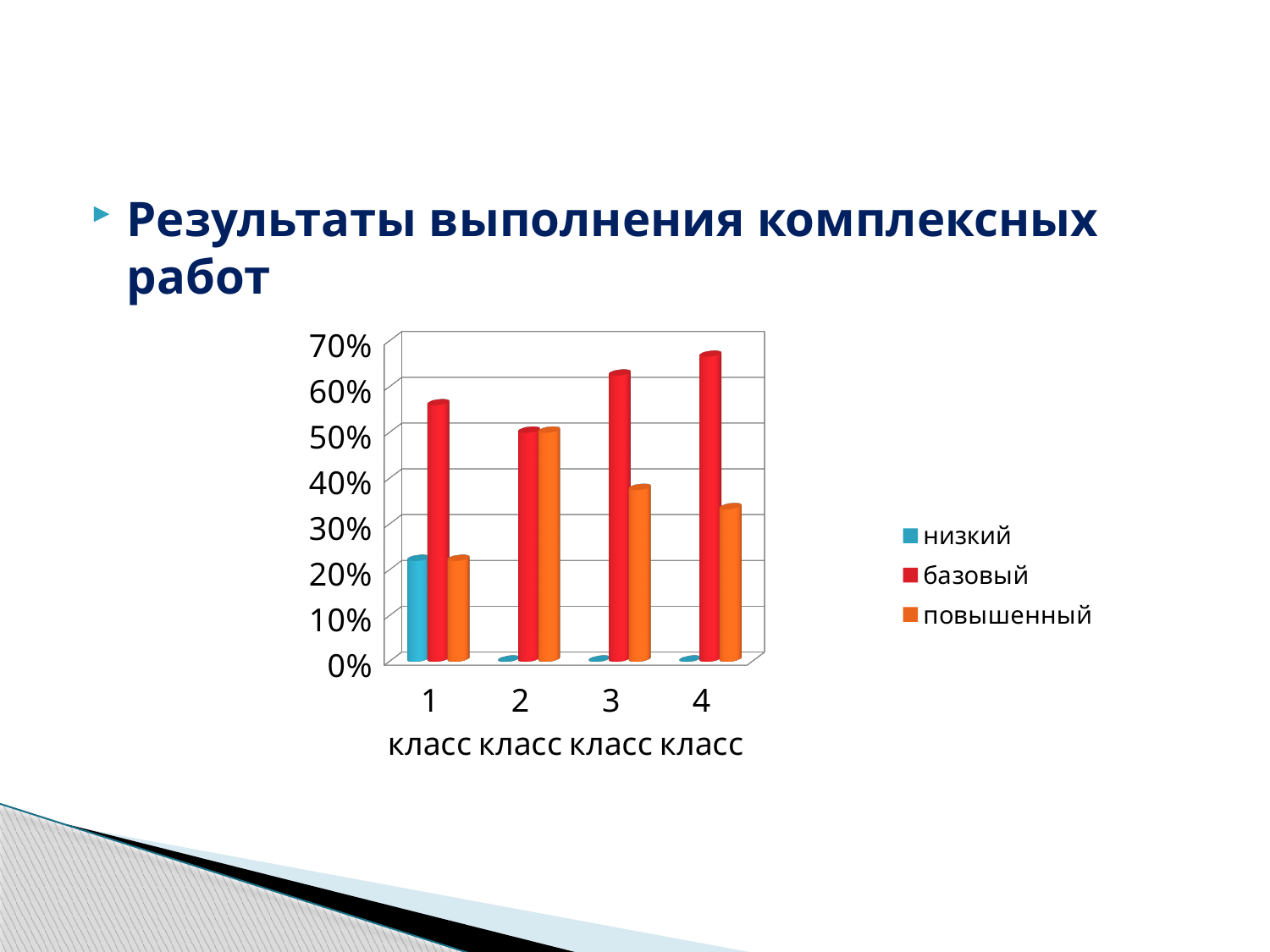
Is the value of повышенный for 4 класс greater or less than 40%? less What kind of chart is shown on the slide? bar chart Which class has the lowest value for повышенный? 1 класс How many classes (categories) are shown on the x axis of the chart? 4 What are the three series named in the chart legend? низкий, базовый, повышенный From 2 класс to 4 класс, does the value of базовый rise or fall? rise Is the value of базовый for 1 класс greater or less than 50%? greater How many series does the chart legend list? 3 Is the value of базовый for 4 класс greater or less than 60%? greater For 3 класс, which is larger: базовый or повышенный? базовый Which class has the highest value for базовый? 4 класс